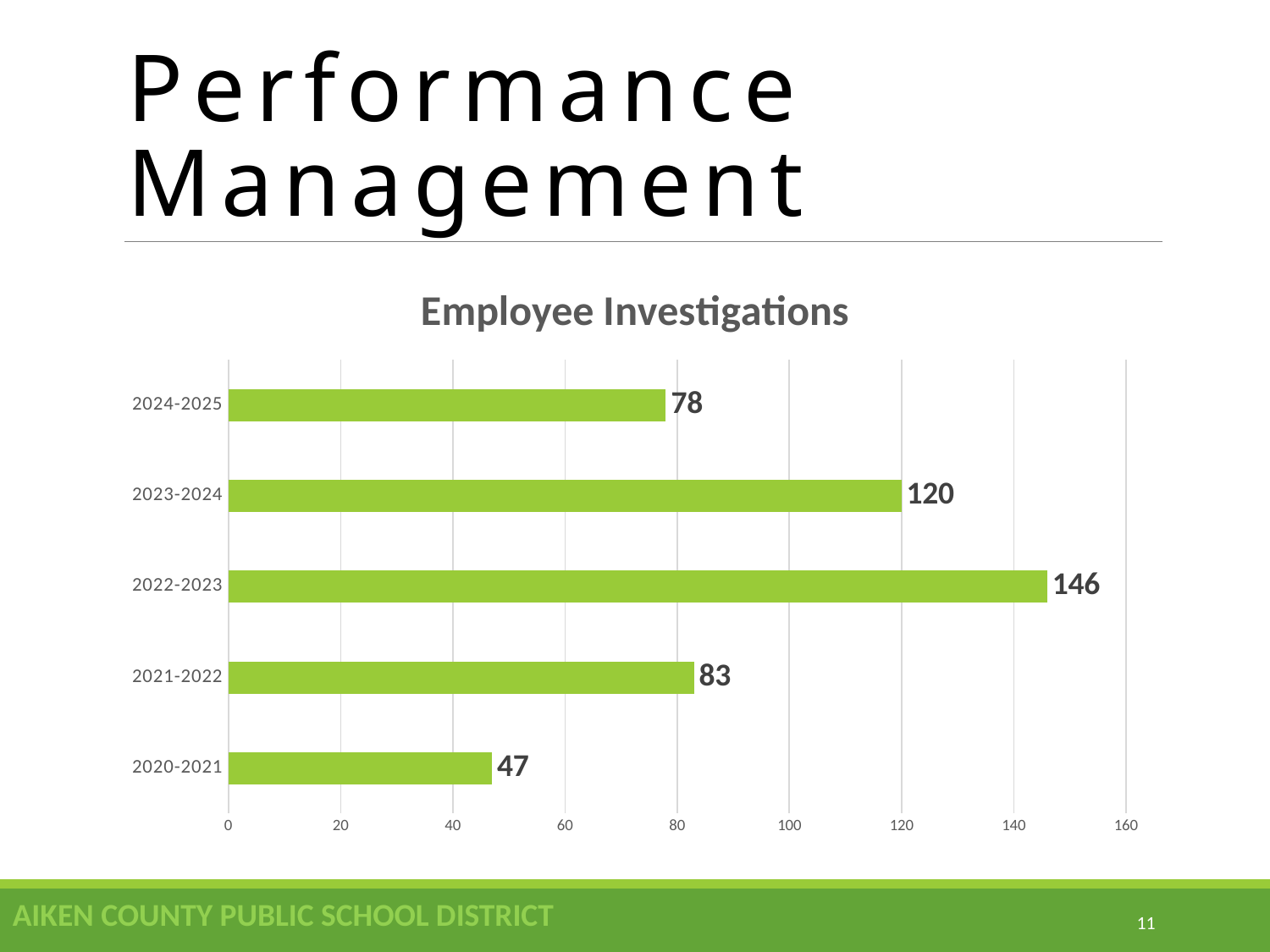
What is the difference between the values for 2022-2023 and 2023-2024? 26 How many school years are shown in the Employee Investigations chart? 5 What is the value for 2022-2023 in the Employee Investigations chart? 146 What is the value for 2024-2025 in the Employee Investigations chart? 78 What kind of chart is used to show Employee Investigations? bar chart Which is larger, the value for 2021-2022 or the value for 2024-2025? 2021-2022 What is the difference between the values for 2021-2022 and 2020-2021? 36 What is the title of the chart on the slide? Employee Investigations Which year has the lowest number of employee investigations? 2020-2021 Is the value for 2023-2024 greater or less than 100? greater What is the value for 2020-2021 in the Employee Investigations chart? 47 Which year has the highest number of employee investigations? 2022-2023